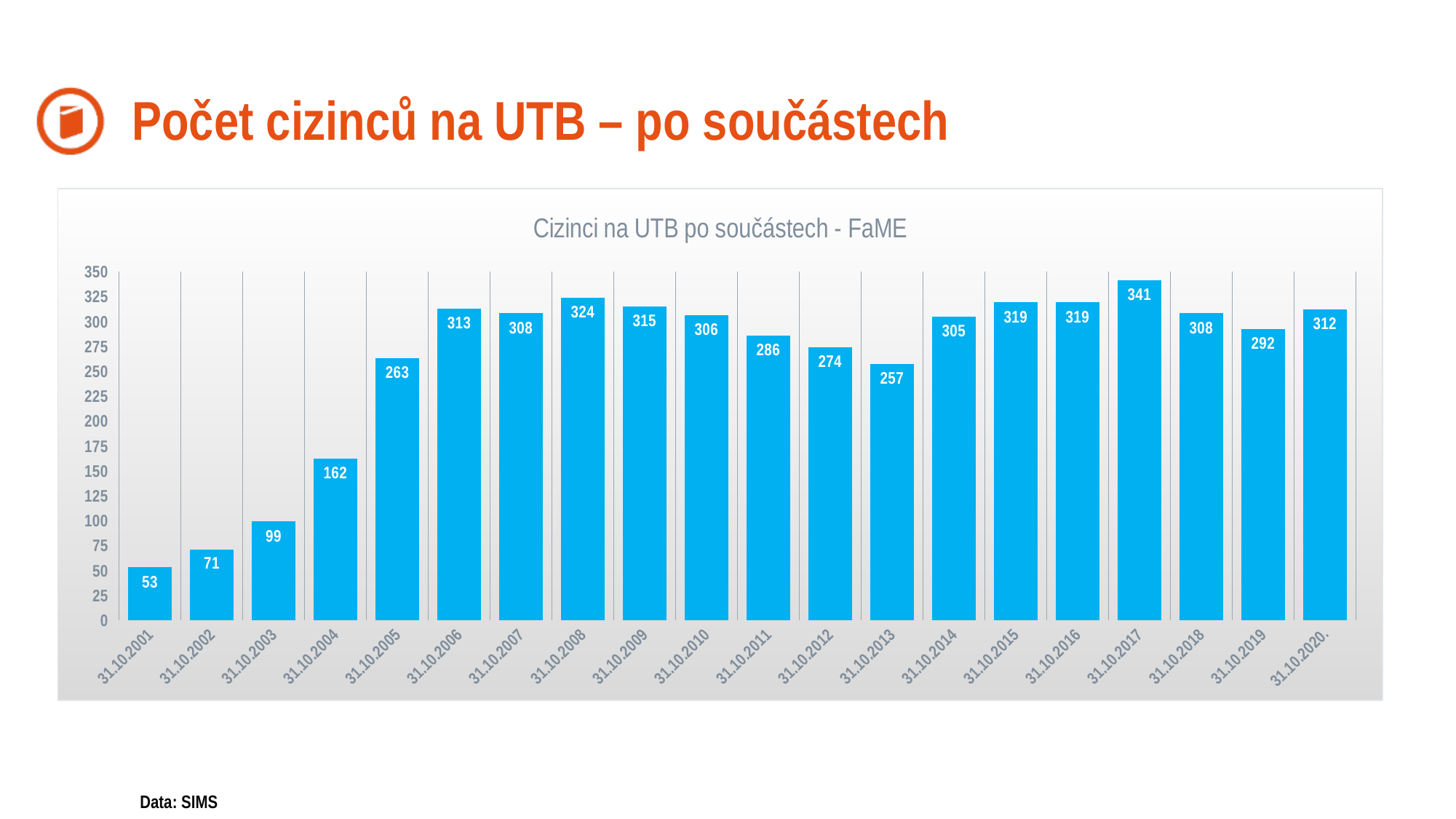
What is the value for 31.10.2017? 341 Do the values rise or fall from 31.10.2001 to 31.10.2006? rise Is the value for 31.10.2005 greater or less than 250? greater What is the difference between the values for 31.10.2017 and 31.10.2019? 49 What is the value for 31.10.2013? 257 What kind of chart is shown? bar chart Which is larger, the value for 31.10.2008 or the value for 31.10.2012? 31.10.2008 Which date has the highest value? 31.10.2017 What is the title of the chart? Cizinci na UTB po součástech - FaME How many dates are shown on the x axis? 20 What is the value for 31.10.2001? 53 Which date has the lowest value? 31.10.2001